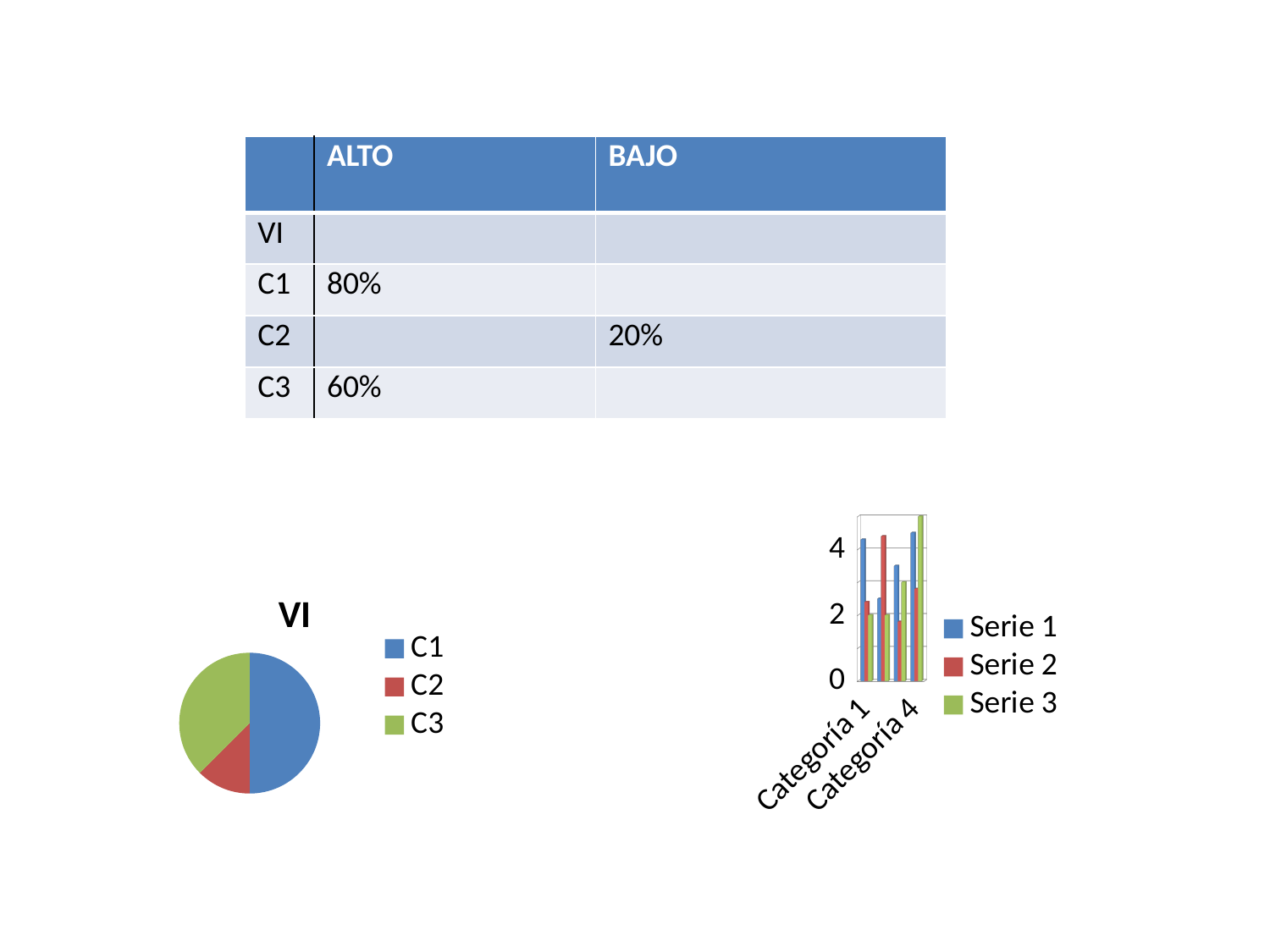
How many series does the legend of the bar chart on the right list? 3 In the bar chart on the right, which series has the highest bar for Categoría 4? Serie 3 What kind of chart is the chart on the right of the slide? bar chart In the pie chart titled "VI", which category has the largest slice? C1 In the bar chart on the right, which series has the lowest bar for Categoría 4? Serie 2 In the pie chart titled "VI", which slice is larger, C2 or C3? C3 In the bar chart on the right, is the value of Serie 2 for Categoría 4 greater or less than 4? less In the pie chart titled "VI", what colour is the C3 slice? green In the pie chart titled "VI", which category has the smallest slice? C2 What kind of chart is the chart titled "VI"? pie chart In the bar chart on the right, is the value of Serie 3 for Categoría 4 greater or less than 4? greater In the pie chart titled "VI", how many slices are there? 3